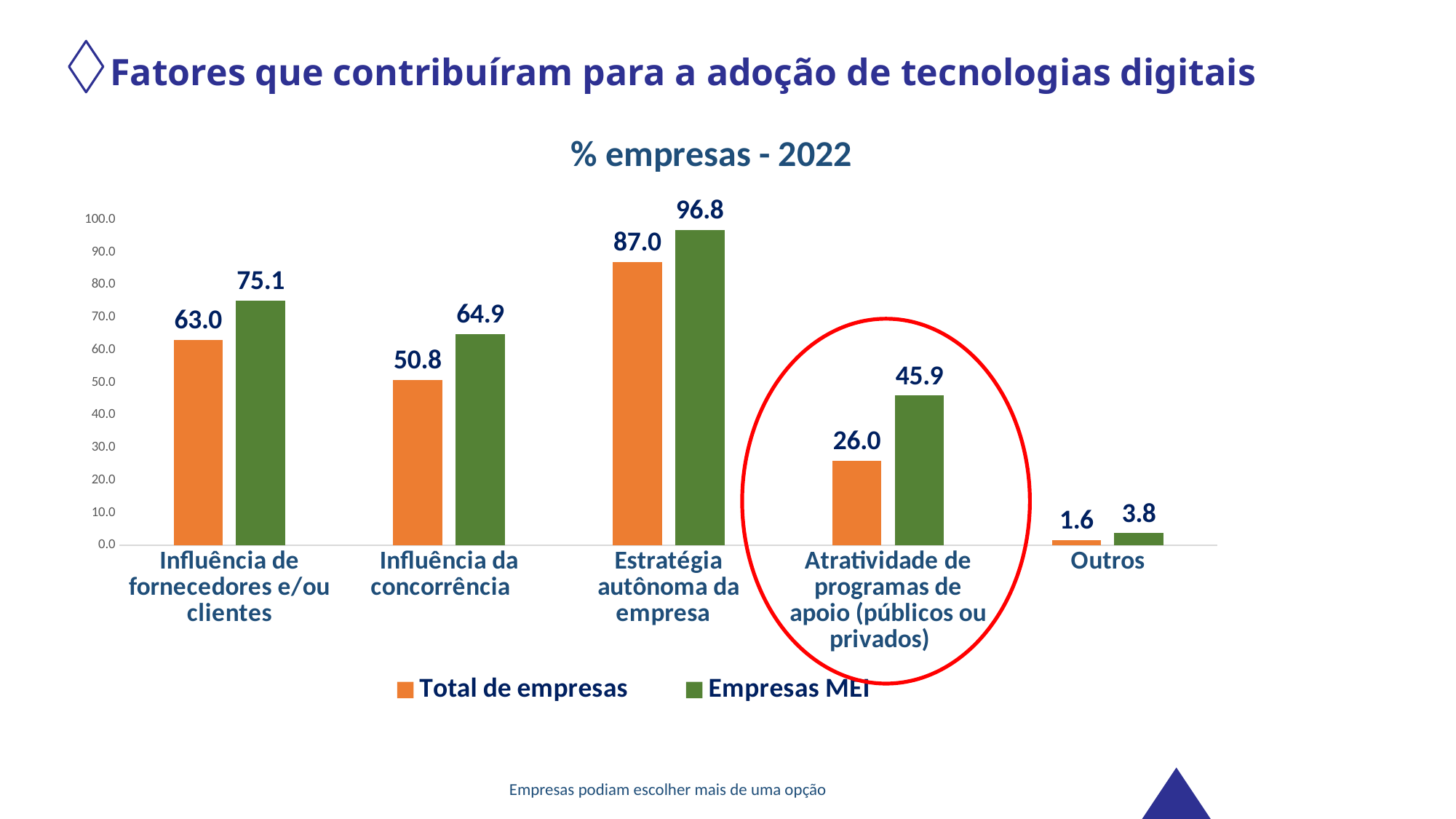
How many series does the legend list? 2 What is the difference between 'Empresas MEI' and 'Total de empresas' in the 'Influência de fornecedores e/ou clientes' category? 12.1 Which is larger in the 'Atratividade de programas de apoio (públicos ou privados)' category: 'Total de empresas' or 'Empresas MEI'? Empresas MEI Is the value for 'Total de empresas' in 'Influência da concorrência' greater or less than 60.0? less How many categories are shown on the x axis? 5 What is the value for 'Empresas MEI' in the 'Influência da concorrência' category? 64.9 What kind of chart is shown on the slide? Bar chart Which category has the lowest value for 'Total de empresas'? Outros What is the value for 'Empresas MEI' in the 'Atratividade de programas de apoio (públicos ou privados)' category? 45.9 What is the title of the chart? % empresas - 2022 What is the value for 'Total de empresas' in the 'Estratégia autônoma da empresa' category? 87.0 Which category has the highest value for 'Empresas MEI'? Estratégia autônoma da empresa